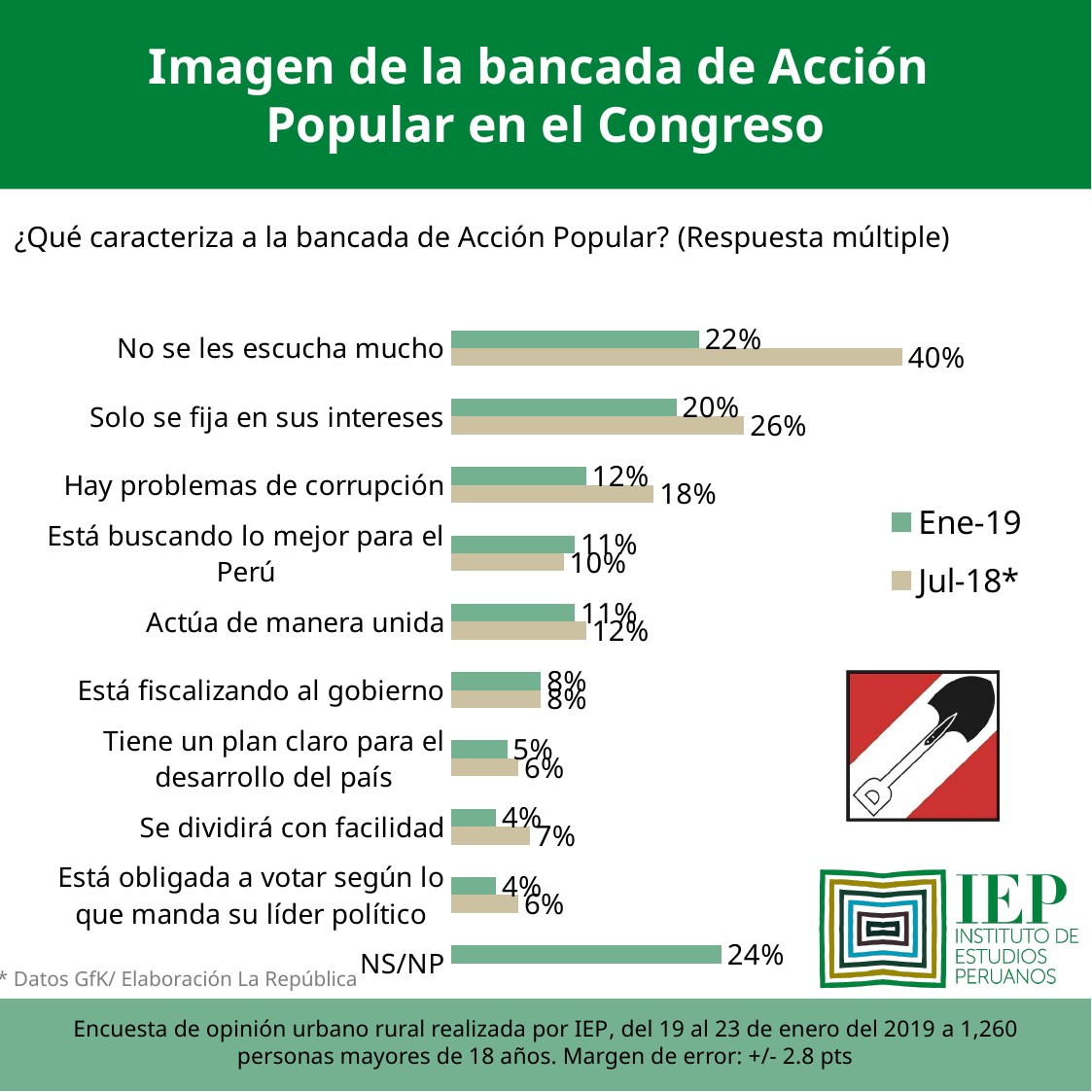
Which category has the highest Jul-18* value? No se les escucha mucho What is the difference between the Jul-18* and Ene-19 values for "No se les escucha mucho"? 18% What is the Jul-18* value for "Hay problemas de corrupción"? 18% What is the Ene-19 value for "No se les escucha mucho"? 22% How many series does the legend list? 2 What is the Jul-18* value for "No se les escucha mucho"? 40% What kind of chart is shown on the slide? Bar chart What is the difference between the Jul-18* and Ene-19 values for "Solo se fija en sus intereses"? 6% What is the Ene-19 value for "NS/NP"? 24% How many categories are shown on the chart? 10 For "Está buscando lo mejor para el Perú", which is larger: the Ene-19 value or the Jul-18* value? Ene-19